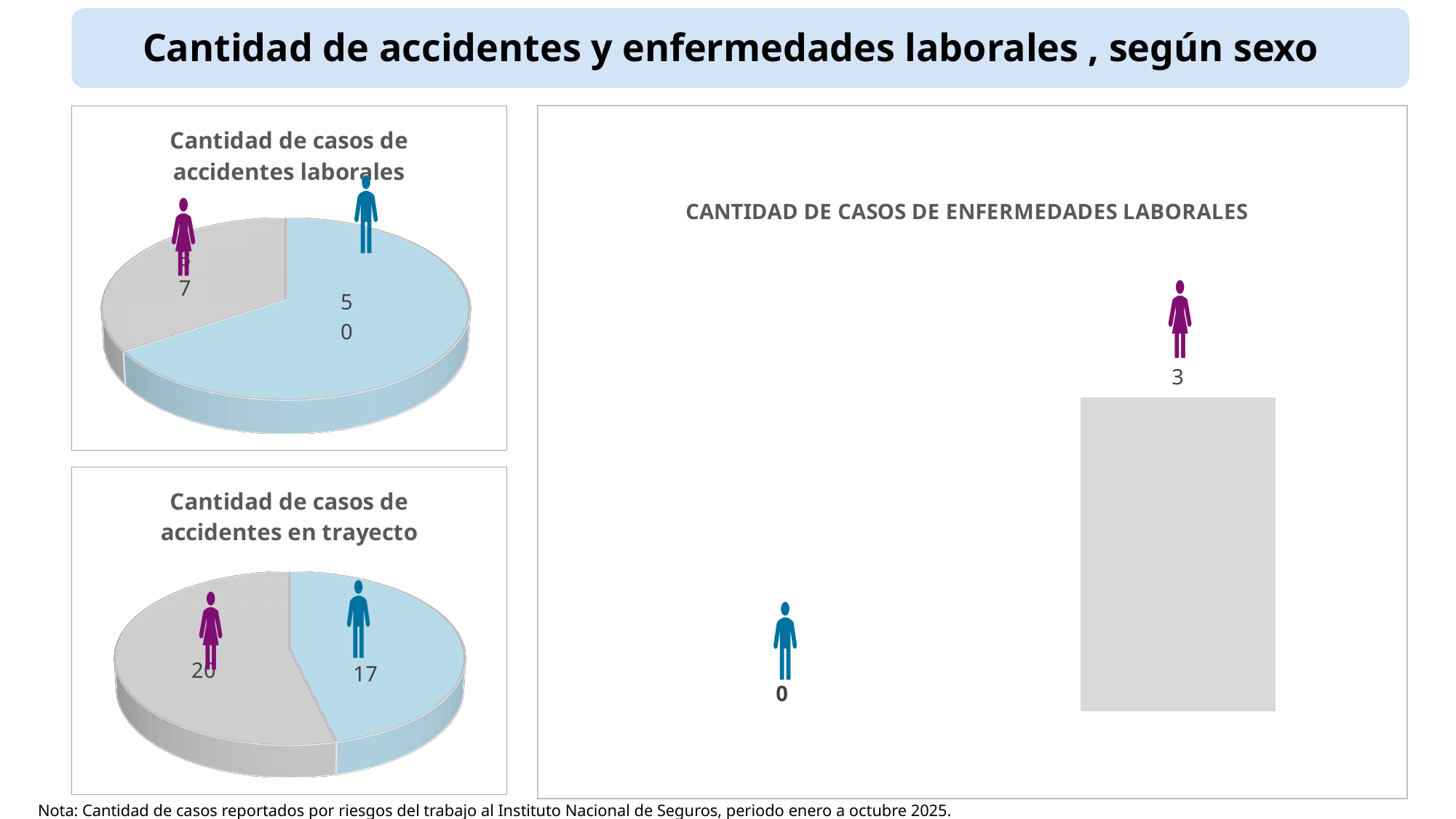
What kind of chart is 'CANTIDAD DE CASOS DE ENFERMEDADES LABORALES'? Bar chart In the chart titled 'CANTIDAD DE CASOS DE ENFERMEDADES LABORALES', what value is shown for the male icon? 0 In the chart titled 'Cantidad de casos de accidentes laborales', what value is shown next to the female icon? 7 In the chart titled 'Cantidad de casos de accidentes en trayecto', which group has the larger value, the female icon or the male icon? Female icon How many charts are shown on the slide? 3 In the chart titled 'Cantidad de casos de accidentes en trayecto', what value is shown next to the male icon? 17 In the chart titled 'Cantidad de casos de accidentes en trayecto', what is the difference between the female and male values? 3 What kind of chart is 'Cantidad de casos de accidentes laborales'? Pie chart In the chart titled 'CANTIDAD DE CASOS DE ENFERMEDADES LABORALES', what value is shown for the female icon? 3 In the chart titled 'Cantidad de casos de accidentes laborales', what is the difference between the male and female values? 43 In the chart titled 'Cantidad de casos de accidentes en trayecto', what value is shown next to the female icon? 20 In the chart titled 'Cantidad de casos de accidentes laborales', what value is shown next to the male icon? 50